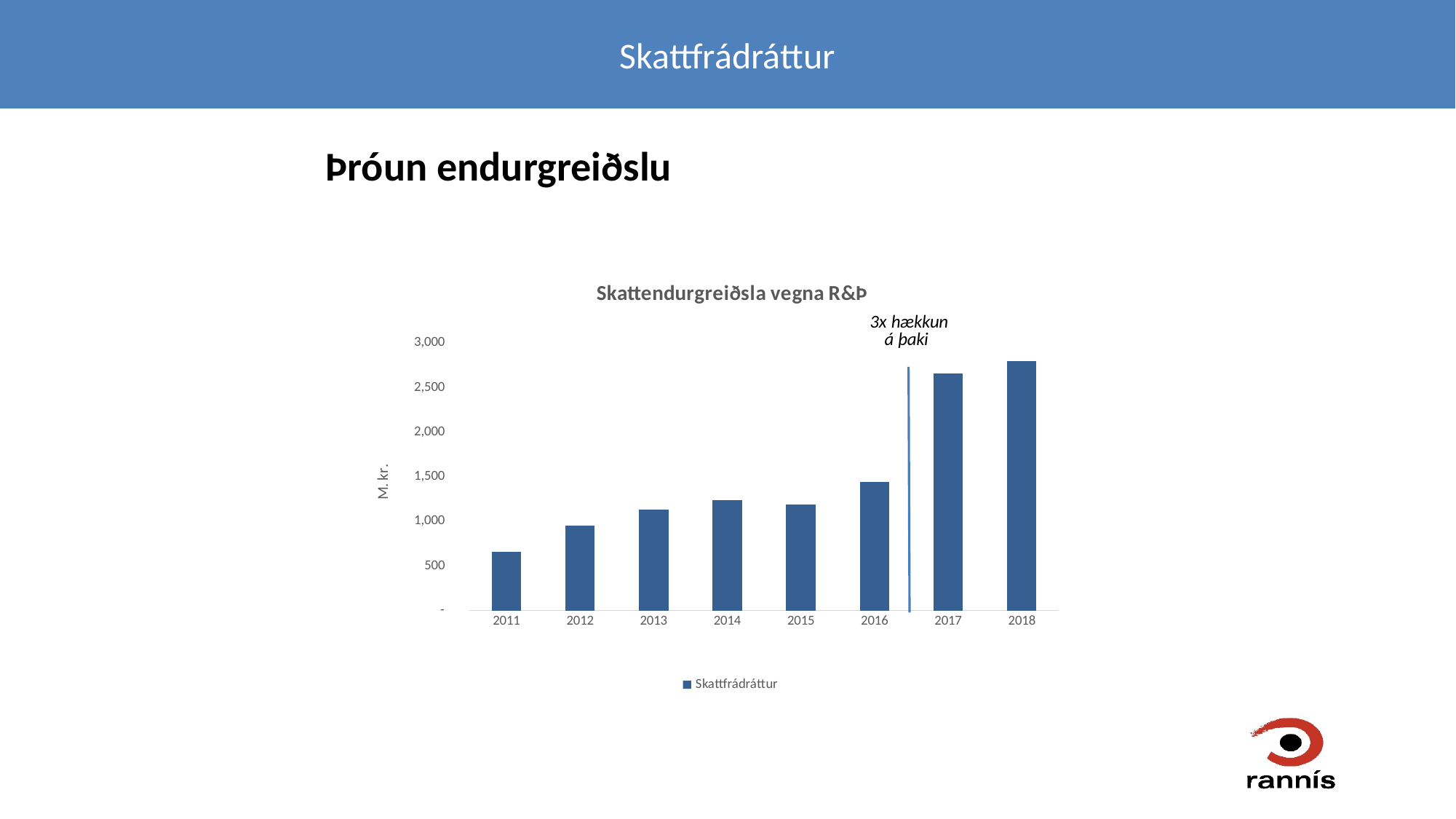
How many years are shown on the x axis of the chart? 8 Is the value for 2011 greater or less than 1,000? less Do the values generally rise or fall from 2011 to 2018? rise Which year has the highest value in the chart? 2018 Is the value for 2016 greater or less than 1,500? less What kind of chart is shown on the slide? Bar chart Which year has the lowest value in the chart? 2011 Is the value for 2017 greater or less than 2,500? greater What is the title of the chart? Skattendurgreiðsla vegna R&Þ What is the label on the vertical axis of the chart? M. kr. How many series does the legend list? 1 Which year has the larger value, 2015 or 2016? 2016